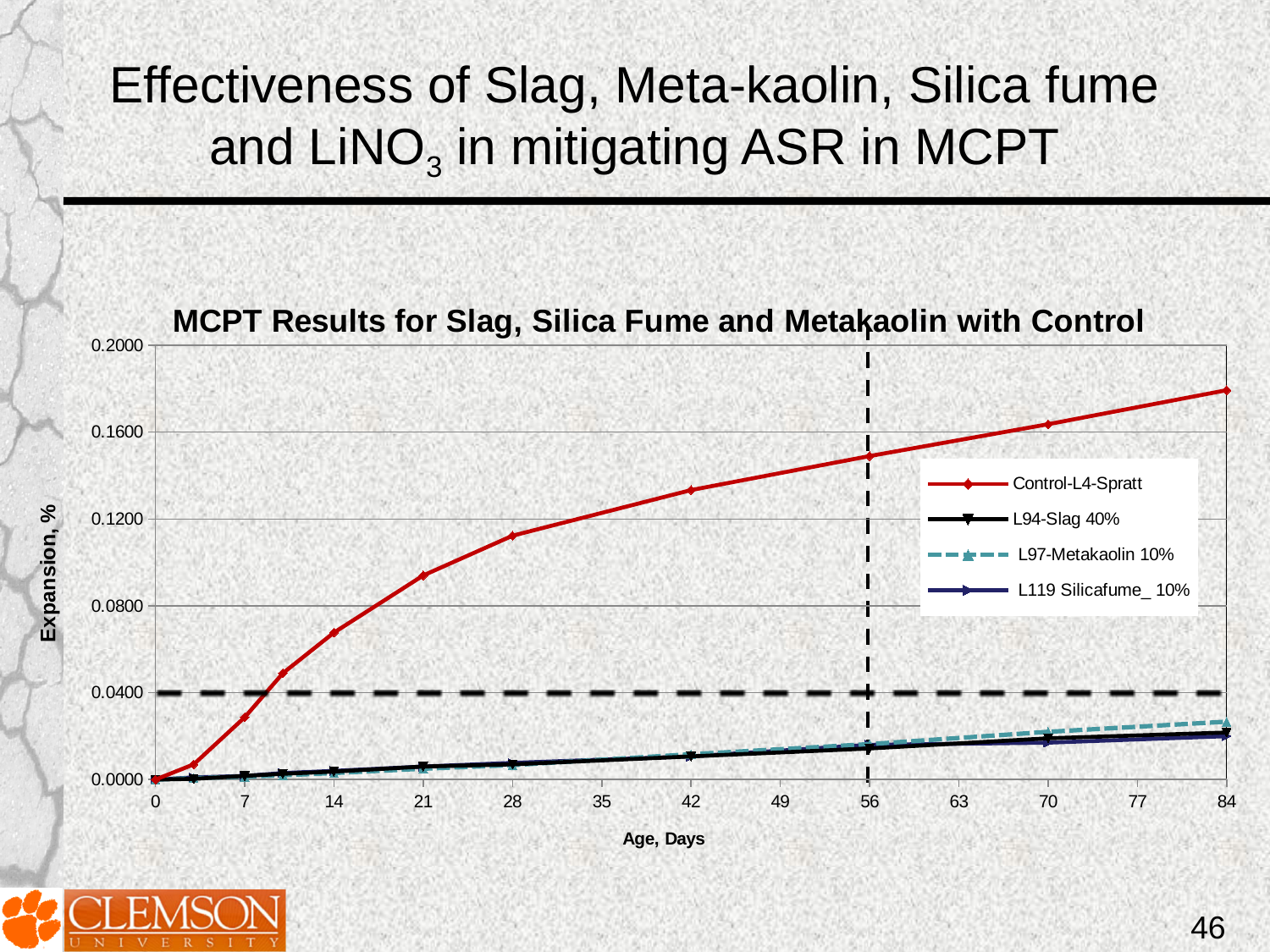
Does the expansion for Control-L4-Spratt rise or fall as age increases from 0 to 84 days? rise Is the expansion for L119 Silicafume_ 10% at 42 days greater or less than 0.0400? less At 84 days, which has the larger expansion: Control-L4-Spratt or L97-Metakaolin 10%? Control-L4-Spratt Is the expansion for Control-L4-Spratt at 84 days greater or less than 0.1600? greater What is the label of the y axis? Expansion, % What is the title of the chart? MCPT Results for Slag, Silica Fume and Metakaolin with Control What kind of chart is shown on the slide? line chart Is the expansion for Control-L4-Spratt at 14 days greater or less than 0.0400? greater Which series has the highest expansion at 84 days? Control-L4-Spratt How many series does the chart legend list? 4